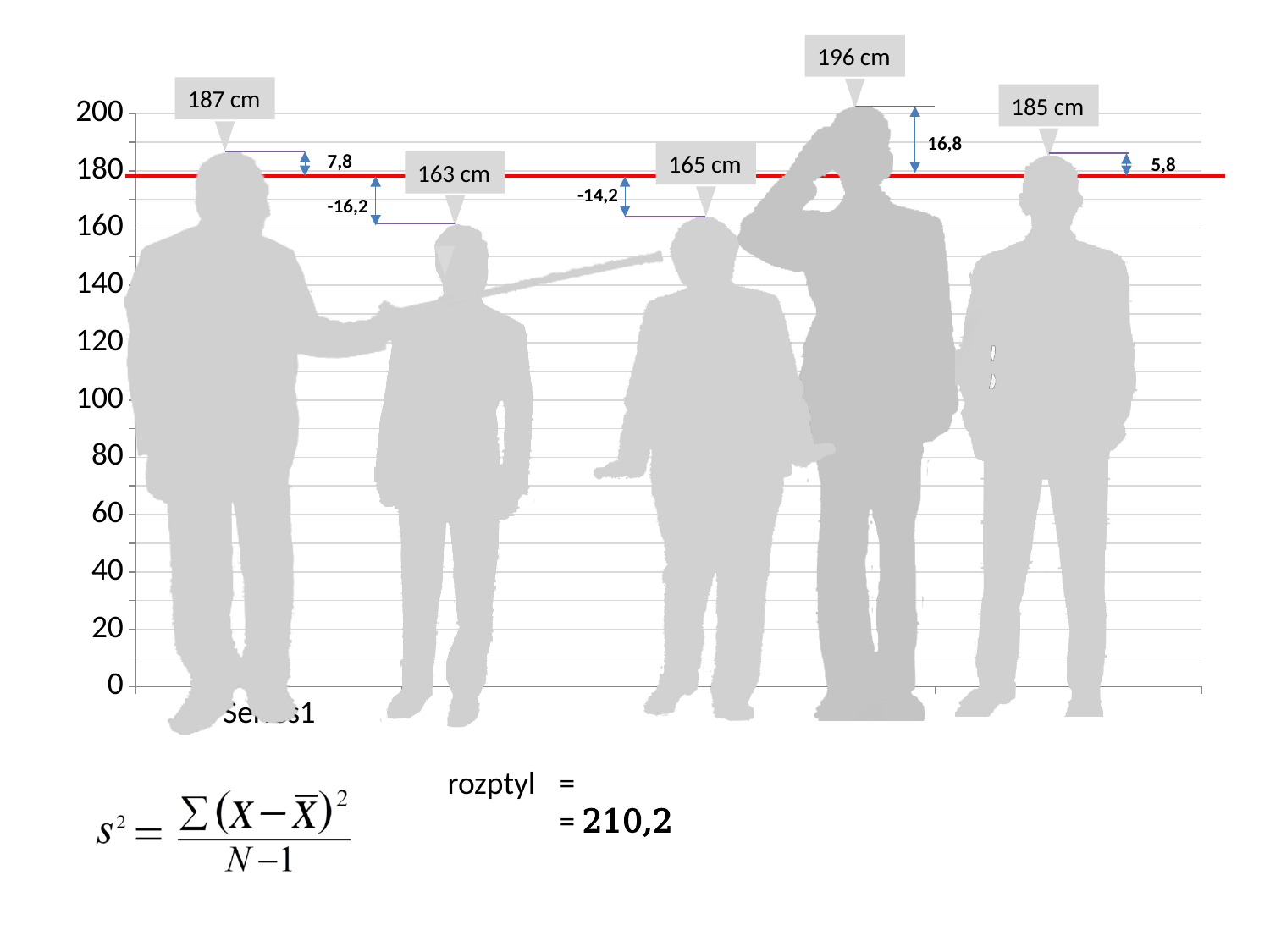
Which figure has the smallest height? The second figure (163 cm) What is the height shown for the first (leftmost) figure? 187 cm Which is taller, the first figure or the fifth figure? The first figure (187 cm) What deviation from the red mean line is labelled for the fourth figure? 16,8 What is the height shown for the second figure from the left? 163 cm How many figures (data points) are shown in the chart? 5 What is the height shown for the fourth figure from the left? 196 cm Is the height of the third figure greater or less than 180? less What is the difference in height between the tallest figure (196 cm) and the shortest figure (163 cm)? 33 cm Which figure has the greatest height? The fourth figure (196 cm) What is the height shown for the rightmost figure? 185 cm What value of the variance (rozptyl) is given below the chart? 210,2